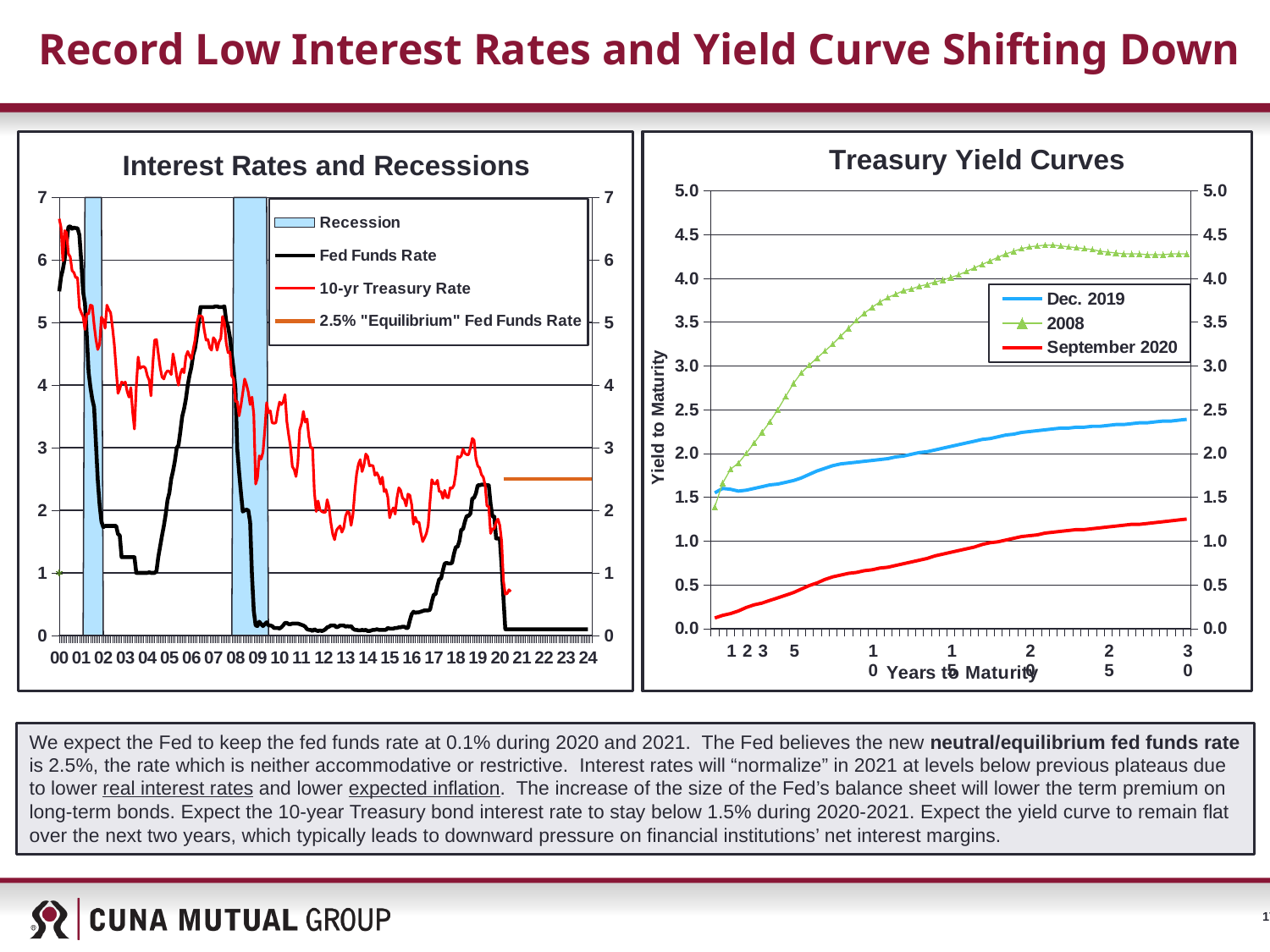
How many series does the legend of the "Treasury Yield Curves" chart list? 3 In the "Interest Rates and Recessions" chart, is the Fed Funds Rate in 2004 greater or less than 2? less In the "Interest Rates and Recessions" chart, is the 10-yr Treasury Rate at the start of 2000 greater or less than 6? greater What kind of chart is the "Interest Rates and Recessions" chart? line chart How many entries does the legend of the "Interest Rates and Recessions" chart list? 4 In the "Interest Rates and Recessions" chart, what value is given for the "Equilibrium" Fed Funds Rate in the legend? 2.5% In the "Treasury Yield Curves" chart, which series has the highest yields? 2008 In the "Treasury Yield Curves" chart, which series has the lowest yields? September 2020 In the "Interest Rates and Recessions" chart, does the Fed Funds Rate rise or fall between 2019 and 2020? fall What is the y-axis label of the "Treasury Yield Curves" chart? Yield to Maturity In the "Treasury Yield Curves" chart, is the Dec. 2019 yield at 30 years to maturity greater or less than 2.5? less